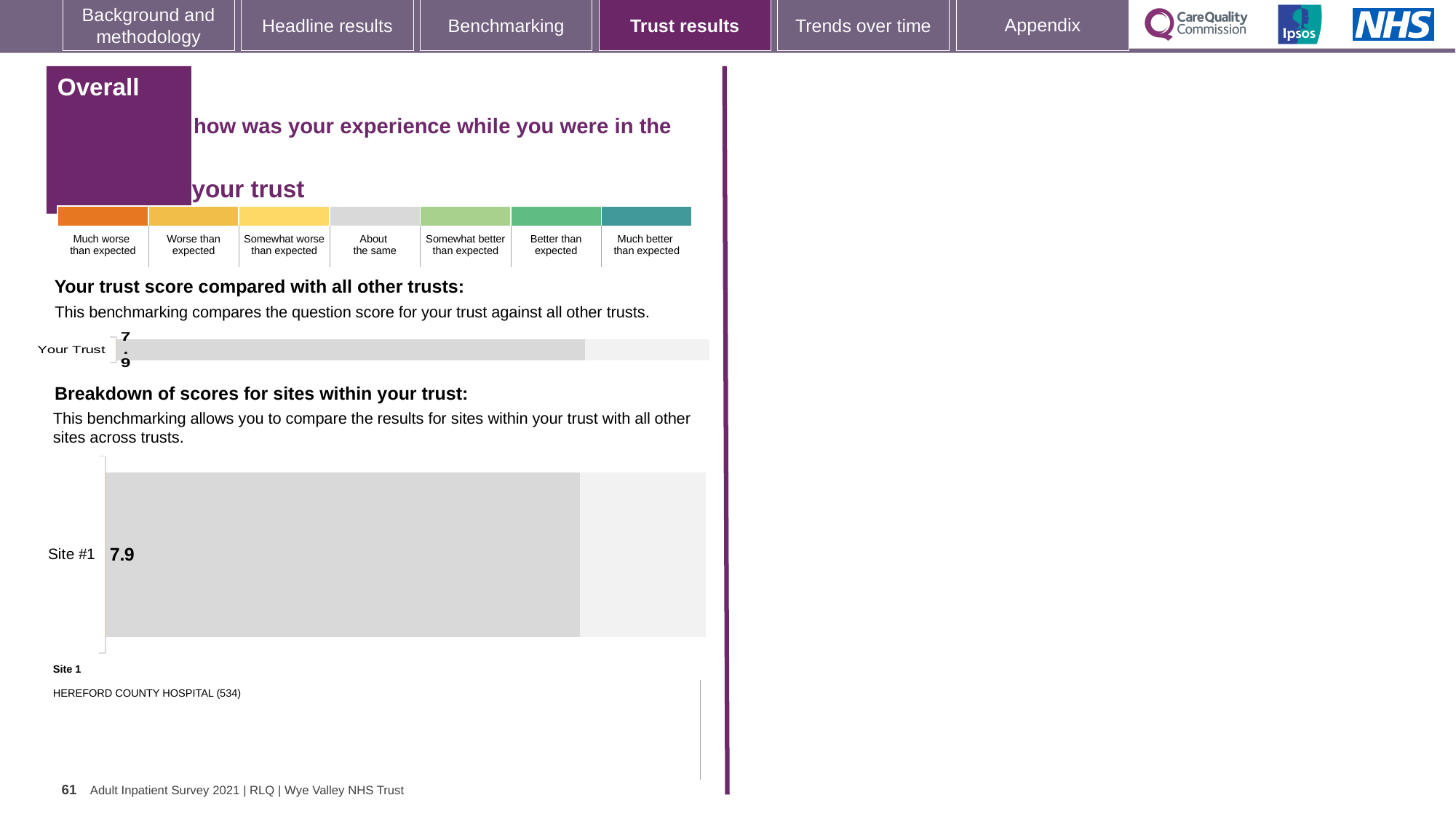
How many sites are plotted in the chart under 'Breakdown of scores for sites within your trust'? 1 In the chart under 'Breakdown of scores for sites within your trust', what is the score shown for Site #1? 7.9 What kind of chart is used under 'Breakdown of scores for sites within your trust'? Bar chart How many bars are plotted in the chart under 'Your trust score compared with all other trusts'? 1 Is the Site #1 score in the site breakdown chart higher than, lower than, or the same as the Your Trust score in the trust chart? The same In the chart under 'Your trust score compared with all other trusts', what is the score shown for Your Trust? 7.9 What kind of chart is used under 'Your trust score compared with all other trusts'? Bar chart What is the difference between the Your Trust score and the Site #1 score? 0.0 According to the site key below the site breakdown chart, which hospital is Site 1? HEREFORD COUNTY HOSPITAL What is the label of the single category in the chart under 'Your trust score compared with all other trusts'? Your Trust